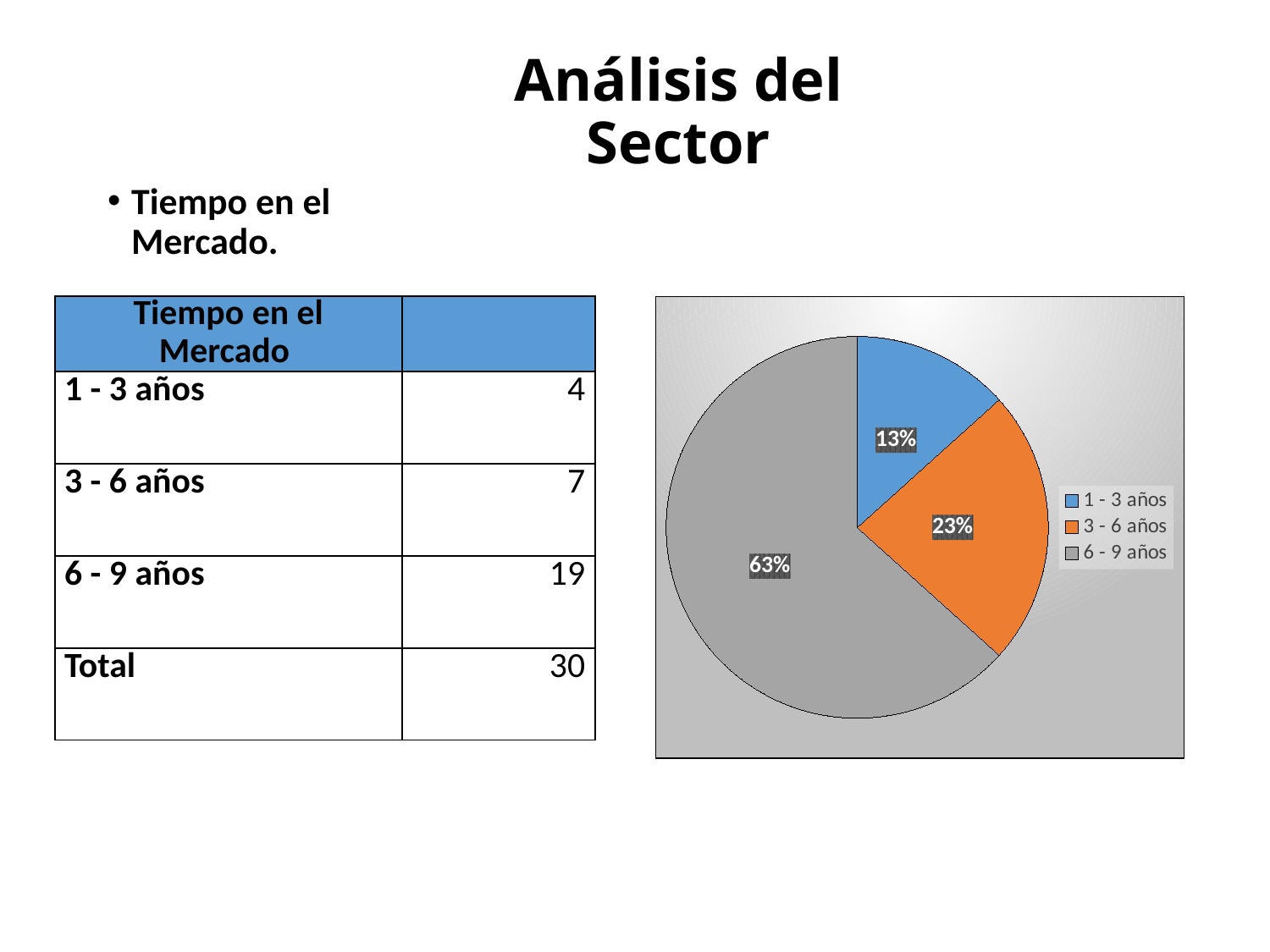
What percentage of the pie chart does the '1 - 3 años' slice represent? 13% How many entries does the legend of the pie chart list? 3 How many slices does the pie chart have? 3 What percentage of the pie chart does the '6 - 9 años' slice represent? 63% What is the difference in percentage points between the '6 - 9 años' slice and the '3 - 6 años' slice? 40% What colour is the '1 - 3 años' slice in the pie chart? blue What colour is the '6 - 9 años' slice in the pie chart? grey What type of chart is shown on the slide? pie chart What percentage of the pie chart does the '3 - 6 años' slice represent? 23% Which slice is larger in the pie chart, '3 - 6 años' or '1 - 3 años'? 3 - 6 años Which category has the largest slice in the pie chart? 6 - 9 años Which category has the smallest slice in the pie chart? 1 - 3 años